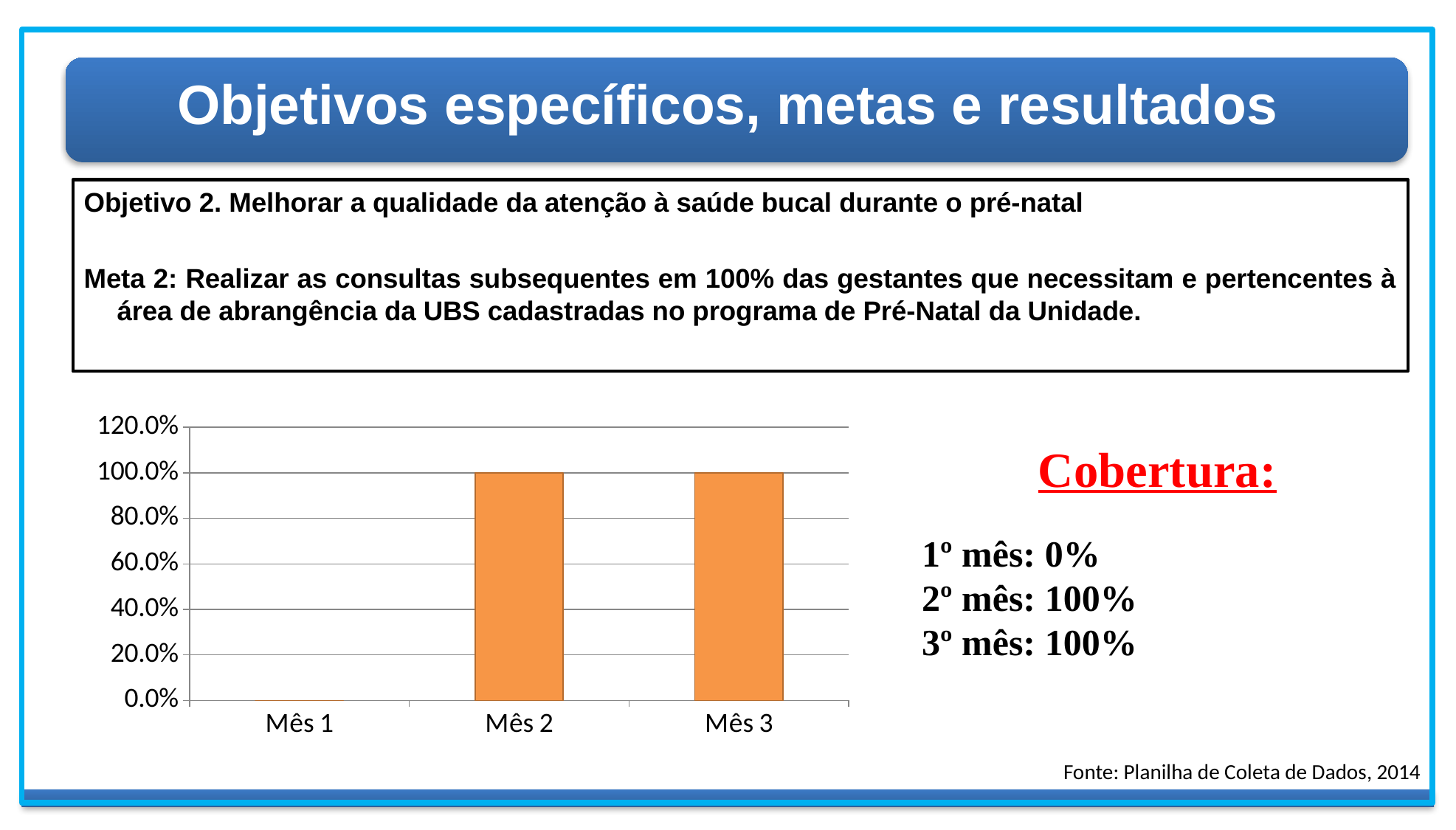
What is the highest value shown on the y axis? 120.0% What kind of chart is shown on the slide? bar chart Which category has the lowest value? Mês 1 What colour are the bars in the chart? orange What is the value for Mês 3? 100.0% Which is larger, the value for Mês 1 or the value for Mês 2? Mês 2 How many categories are shown on the x axis? 3 Is the value for Mês 3 greater or less than 80.0%? greater Does the value rise or fall from Mês 1 to Mês 2? rise What is the value for Mês 2? 100.0% What is the value for Mês 1? 0.0% What is the difference between the value for Mês 2 and the value for Mês 1? 100.0%